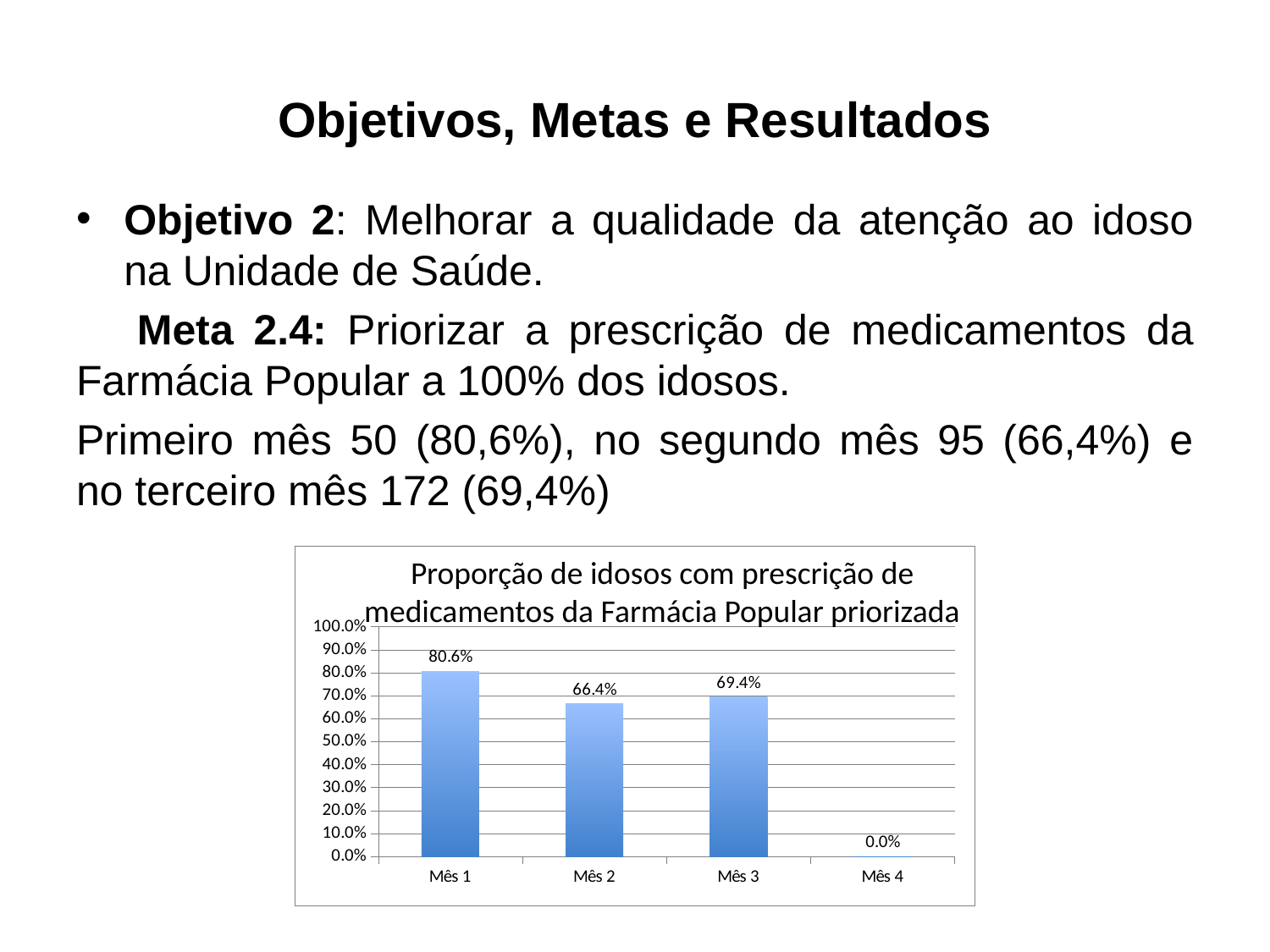
Is the value for Mês 1 greater or less than 70.0%? greater Which month has the highest value? Mês 1 How many categories are shown on the x axis? 4 What is the value for Mês 4? 0.0% Which is larger, the value for Mês 2 or Mês 3? Mês 3 What is the value for Mês 1? 80.6% What kind of chart is shown on the slide? Bar chart What is the value for Mês 2? 66.4% What is the title of the chart? Proporção de idosos com prescrição de medicamentos da Farmácia Popular priorizada What is the value for Mês 3? 69.4% Which month has the lowest value? Mês 4 What is the difference between the values for Mês 1 and Mês 2? 14.2%